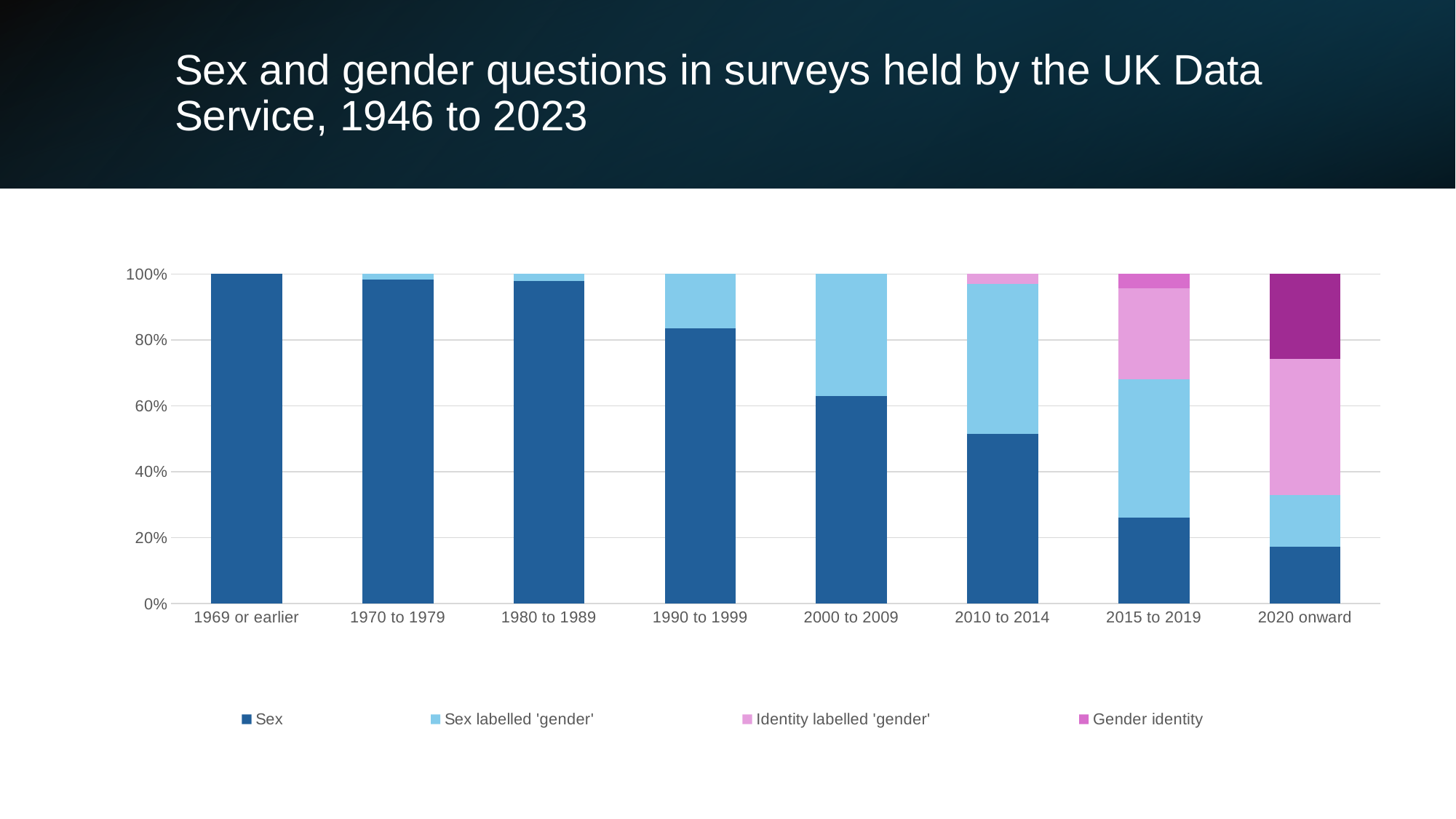
What share of surveys in the '1969 or earlier' period asked about Sex? 100% What kind of chart is shown on the slide? Stacked bar chart How many time-period categories are shown on the x axis? 8 Which period has the smallest Sex share? 2020 onward Is the Sex share for '2020 onward' greater or less than 20%? less Which period has the larger Sex share, '2010 to 2014' or '2015 to 2019'? 2010 to 2014 Is the Sex share for '2015 to 2019' greater or less than 40%? less Is the Sex share for '1990 to 1999' greater or less than 80%? greater How many series does the legend list? 4 Does the Sex share rise or fall across the periods from left to right? Falls